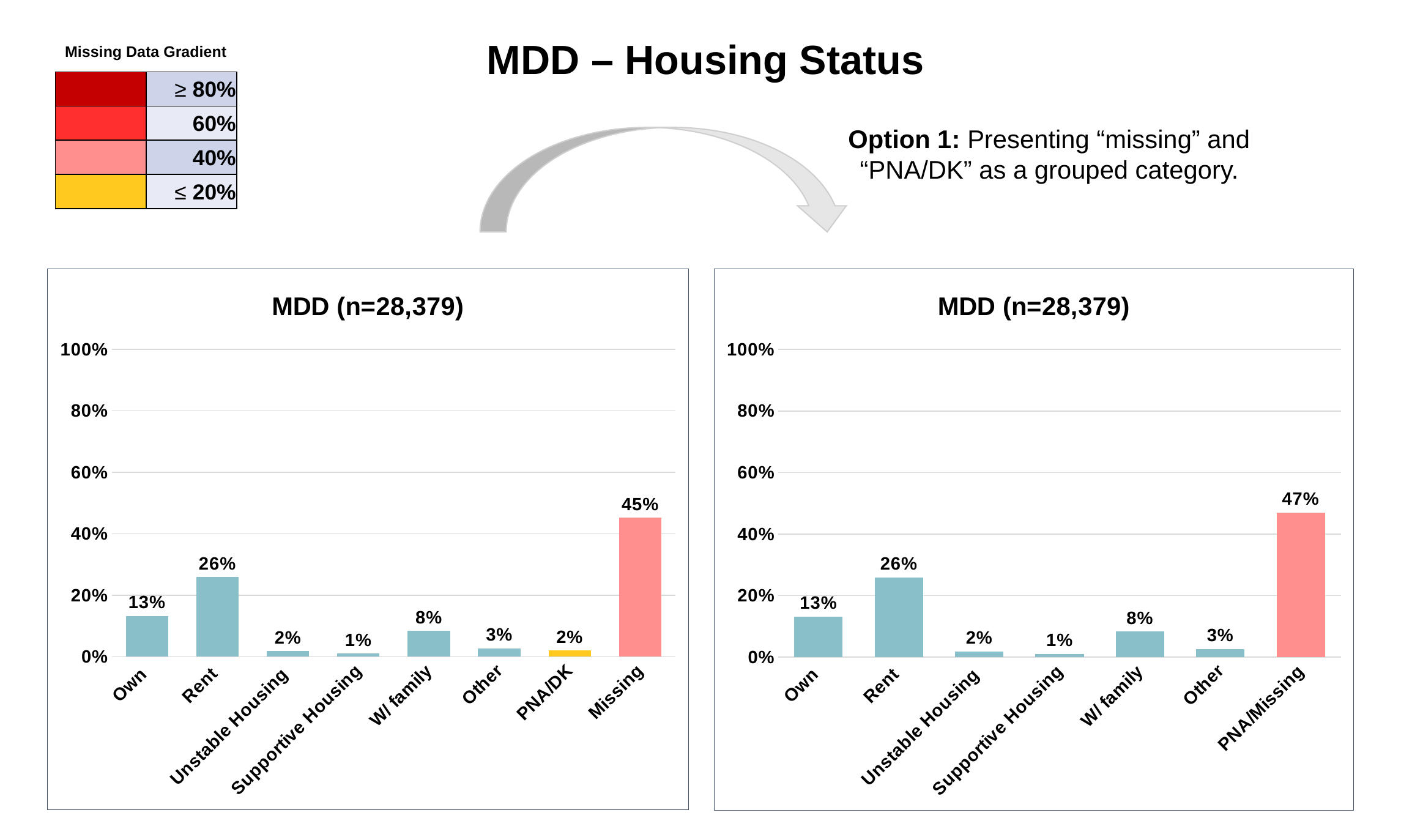
In the left chart, what is the value for PNA/DK? 2% How many categories are shown on the x axis of the right chart? 7 In the left chart, which category has the highest value? Missing In the right chart, which category has the lowest value? Supportive Housing In the right chart, what is the value for W/ family? 8% What kind of chart is the left chart? Bar chart In the left chart, what is the difference between the values for Rent and Own? 13% In the left chart, what is the value for Missing? 45% How many categories are shown on the x axis of the left chart? 8 In the left chart, what is the value for Rent? 26% In the right chart, what is the value for PNA/Missing? 47% In the right chart, which is larger, the value for Own or the value for W/ family? Own